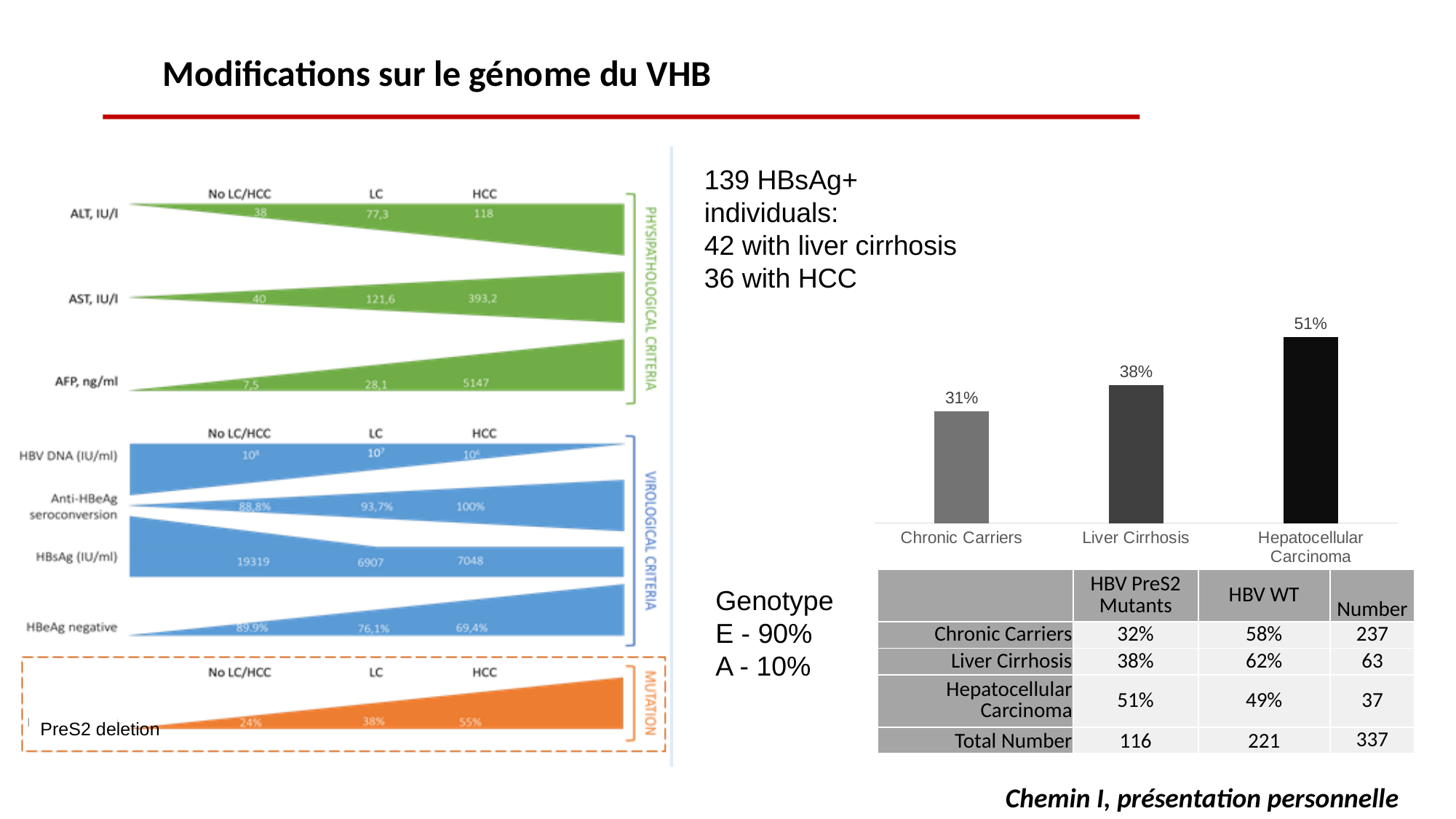
How many categories are shown in the bar chart on the right? 3 In the bar chart on the right, what is the value for Liver Cirrhosis? 38% In the bar chart on the right, what is the difference between the values for Hepatocellular Carcinoma and Chronic Carriers? 20% In the bar chart on the right, which category has the highest value? Hepatocellular Carcinoma In the bar chart on the right, what is the value for Hepatocellular Carcinoma? 51% In the bar chart on the right, which is larger: the value for Liver Cirrhosis or the value for Hepatocellular Carcinoma? Hepatocellular Carcinoma In the bar chart on the right, which category has the lowest value? Chronic Carriers In the bar chart on the right, what is the difference between the values for Liver Cirrhosis and Chronic Carriers? 7% What kind of chart is shown on the right side of the slide? Bar chart In the bar chart on the right, what is the label of the middle category? Liver Cirrhosis In the bar chart on the right, what is the value for Chronic Carriers? 31% In the bar chart on the right, do the values rise or fall from Chronic Carriers to Hepatocellular Carcinoma? Rise